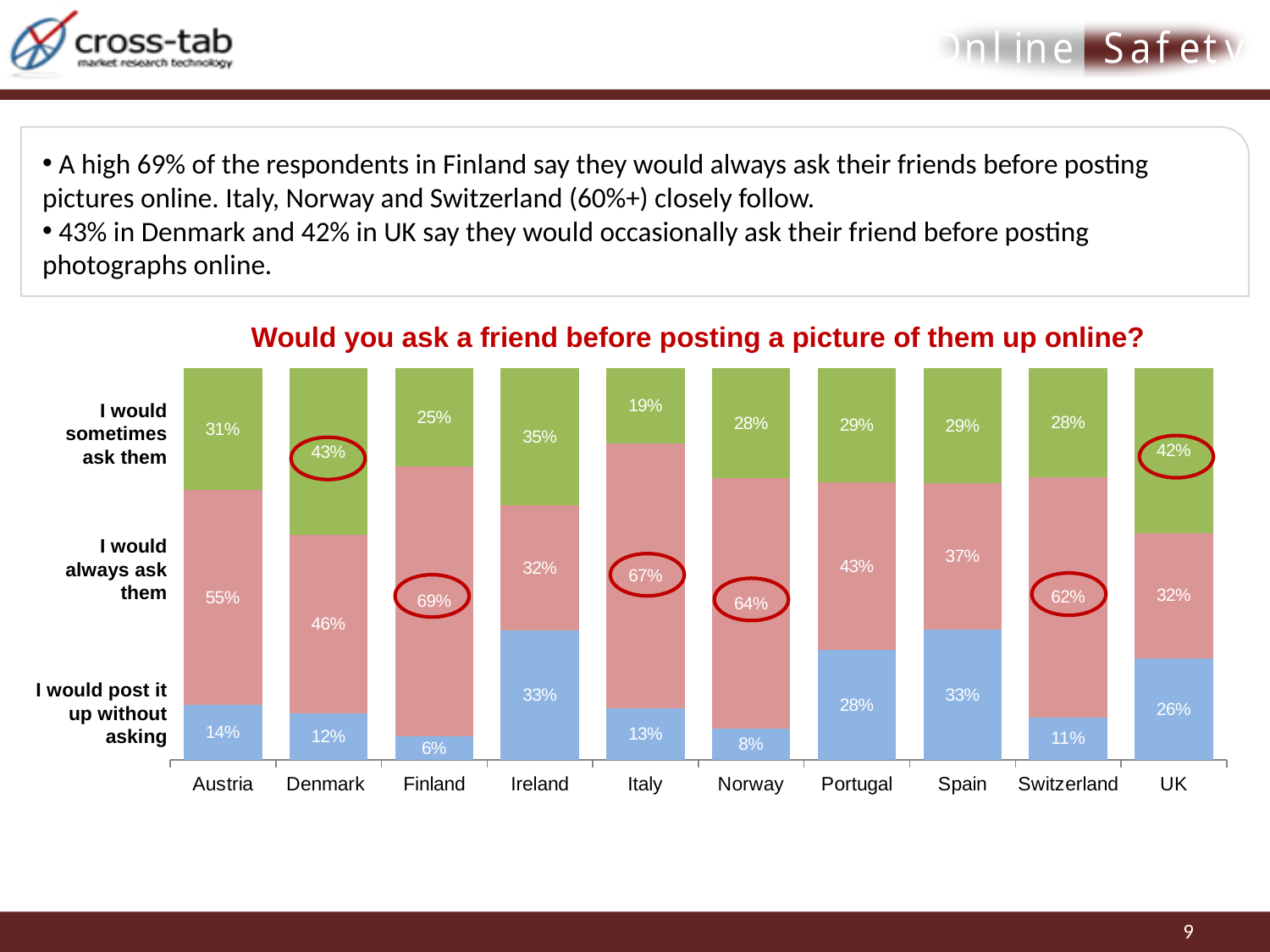
How many countries are shown on the x axis of the chart? 10 What is the title of the chart? Would you ask a friend before posting a picture of them up online? What is the difference between the 'I would always ask them' percentages for Italy and Norway? 3% Which country has the highest percentage of respondents who would always ask their friends before posting a picture? Finland Which country has the lowest percentage of respondents who would sometimes ask a friend? Italy How many response categories are stacked in each bar of the chart? 3 What percentage of respondents in Ireland say they would post a picture up without asking? 33% Which country has the lowest percentage of respondents who would post a picture up without asking? Finland What type of chart is shown on the slide? Stacked bar chart What percentage of respondents in the UK say they would sometimes ask a friend before posting a picture? 42% Which is larger: the 'I would post it up without asking' percentage for Portugal or for the UK? Portugal What percentage of respondents in Finland say they would always ask their friends before posting a picture? 69%